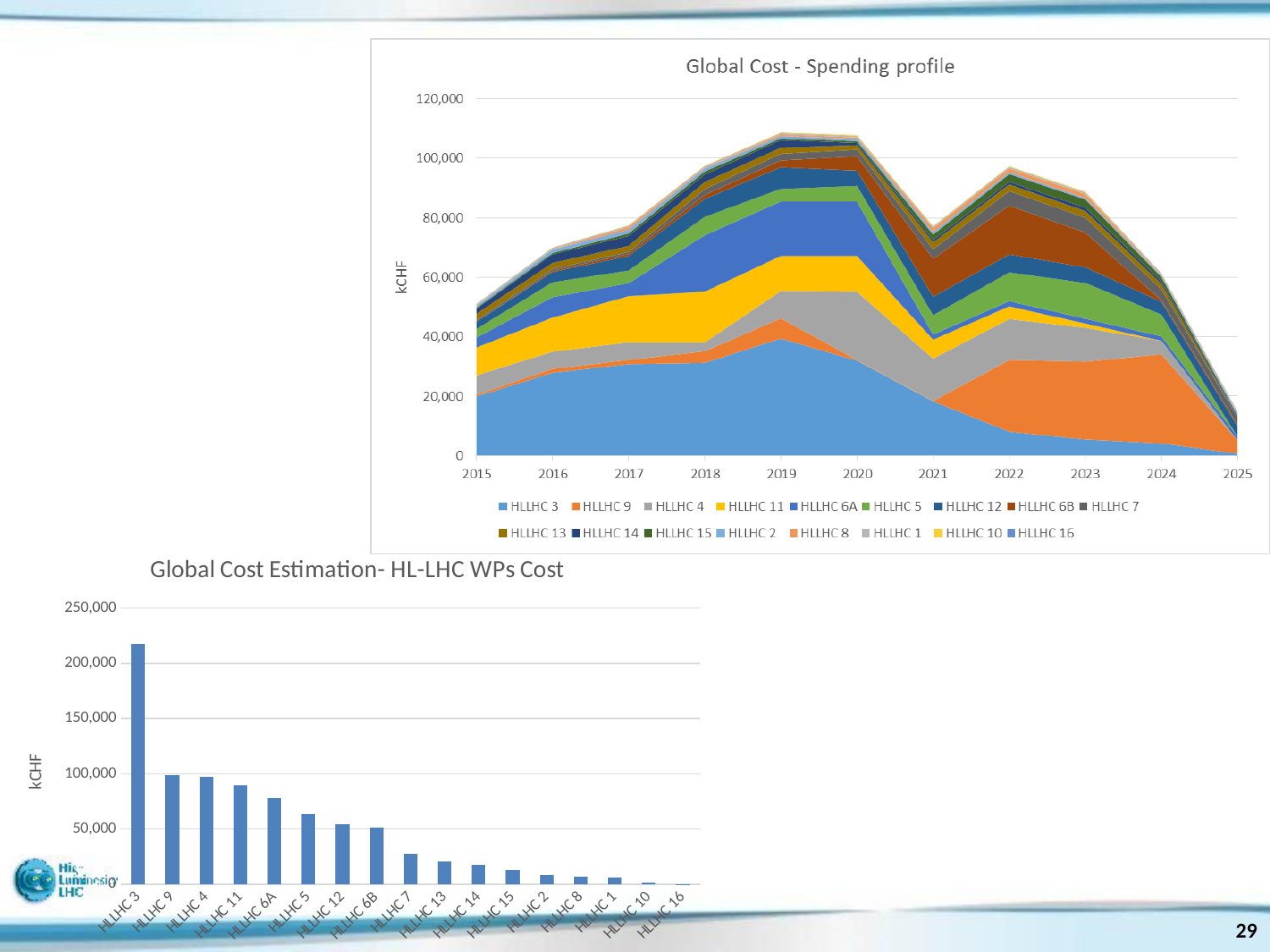
What kind of chart is the bottom chart titled 'Global Cost Estimation- HL-LHC WPs Cost'? bar chart In the bottom chart 'Global Cost Estimation- HL-LHC WPs Cost', is the value for HLLHC 3 greater or less than 200,000? greater In the bottom chart 'Global Cost Estimation- HL-LHC WPs Cost', which is larger, the value for HLLHC 3 or HLLHC 9? HLLHC 3 In the top chart 'Global Cost - Spending profile', does the total spending rise or fall from 2019 to 2021? fall What unit is shown on the y axis of the bottom chart 'Global Cost Estimation- HL-LHC WPs Cost'? kCHF In the top chart 'Global Cost - Spending profile', how many years are shown on the x axis? 11 In the top chart 'Global Cost - Spending profile', is the total stacked value for 2019 greater or less than 100,000? greater In the bottom chart 'Global Cost Estimation- HL-LHC WPs Cost', which work package has the highest cost? HLLHC 3 In the top chart 'Global Cost - Spending profile', how many series does the legend list? 17 What kind of chart is the top chart titled 'Global Cost - Spending profile'? stacked area chart In the bottom chart 'Global Cost Estimation- HL-LHC WPs Cost', is the value for HLLHC 7 greater or less than 50,000? less